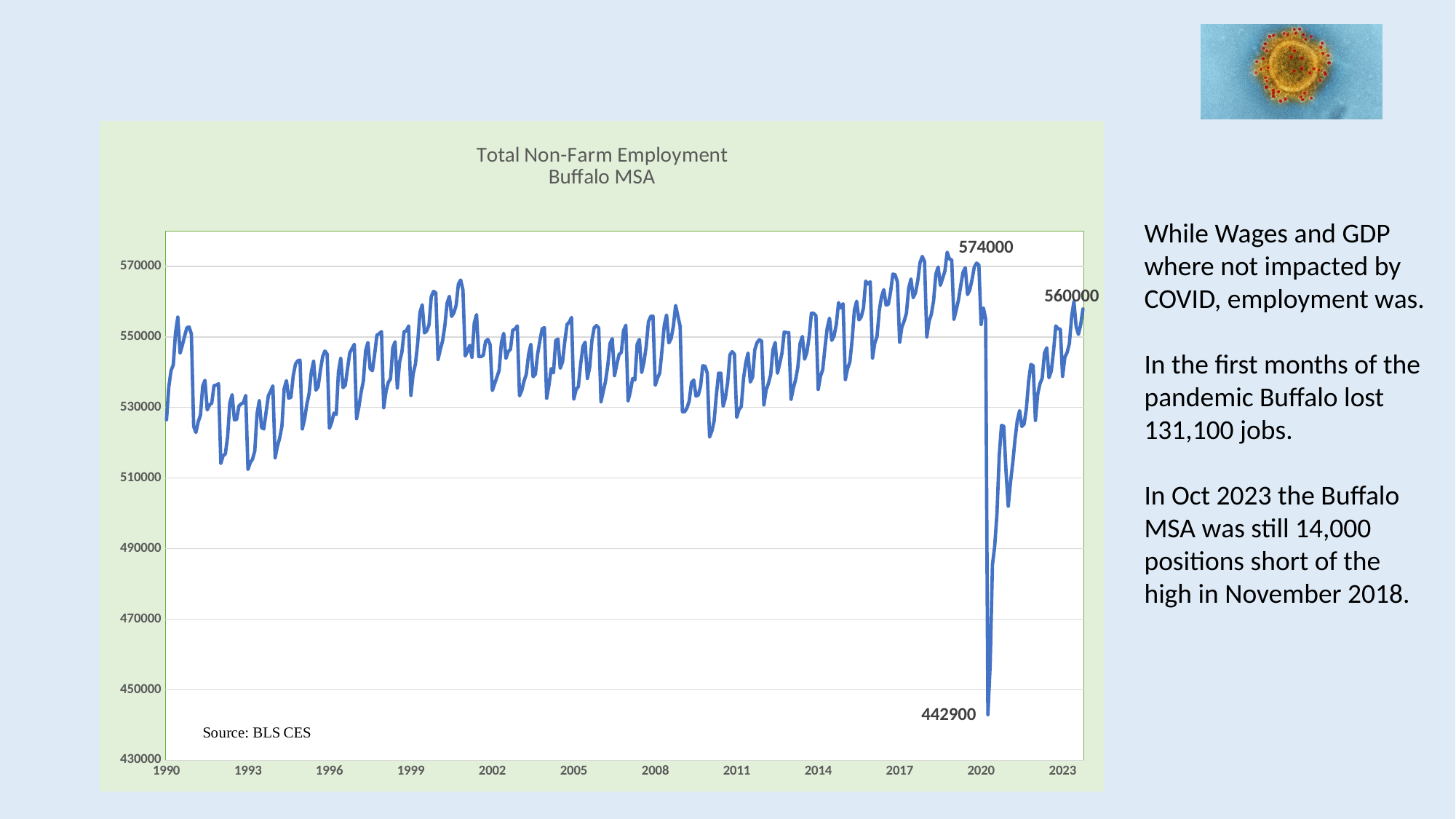
How many data labels are printed on the line? 3 What is the difference between the labeled peak of 574000 and the labeled low of 442900? 131100 What is the title of the chart? Total Non-Farm Employment Buffalo MSA What is the lowest labeled value on the chart? 442900 Which is larger, the labeled value 560000 near 2023 or the labeled value 442900 in 2020? 560000 Is the lowest point of the line around 1993 greater or less than 530000? less What is the highest labeled value on the chart? 574000 What source is cited on the chart? BLS CES Is the peak of the line around 2000 greater or less than 550000? greater What type of chart is shown on the slide? line chart What value is labeled at the right end of the line, around 2023? 560000 What is the difference between the labeled peak of 574000 and the labeled 2023 value of 560000? 14000